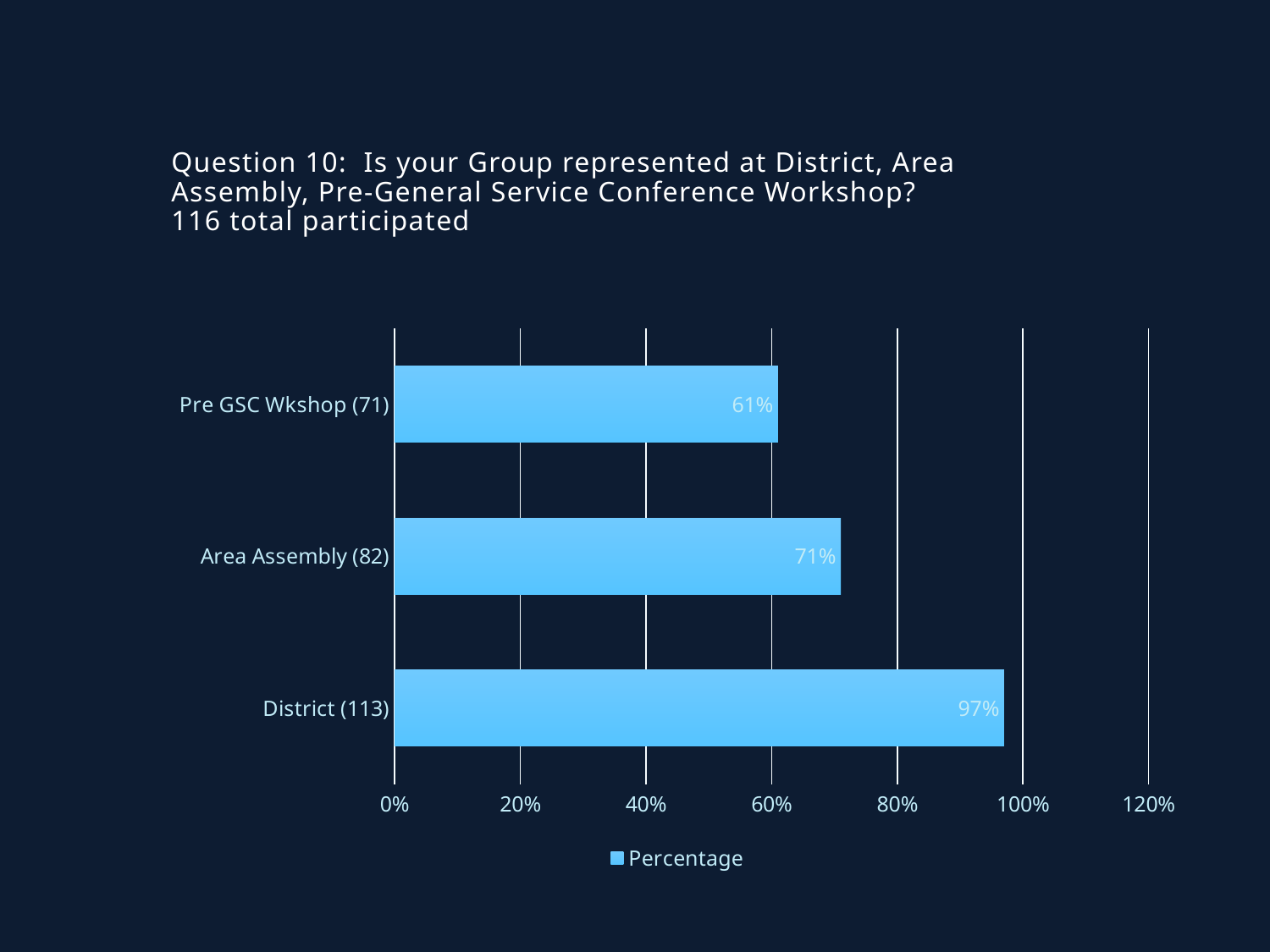
What kind of chart is shown on the slide? Bar chart Which has a larger percentage, Area Assembly (82) or Pre GSC Wkshop (71)? Area Assembly (82) How many categories are shown in the chart? 3 How many series does the legend list? 1 What is the percentage for Pre GSC Wkshop (71)? 61% Which category has the highest percentage? District (113) What is the difference in percentage between Area Assembly (82) and Pre GSC Wkshop (71)? 10% Is the value for District (113) greater or less than 80%? greater What is the percentage for District (113)? 97% What is the percentage for Area Assembly (82)? 71% What is the difference in percentage between District (113) and Pre GSC Wkshop (71)? 36% Which category has the lowest percentage? Pre GSC Wkshop (71)